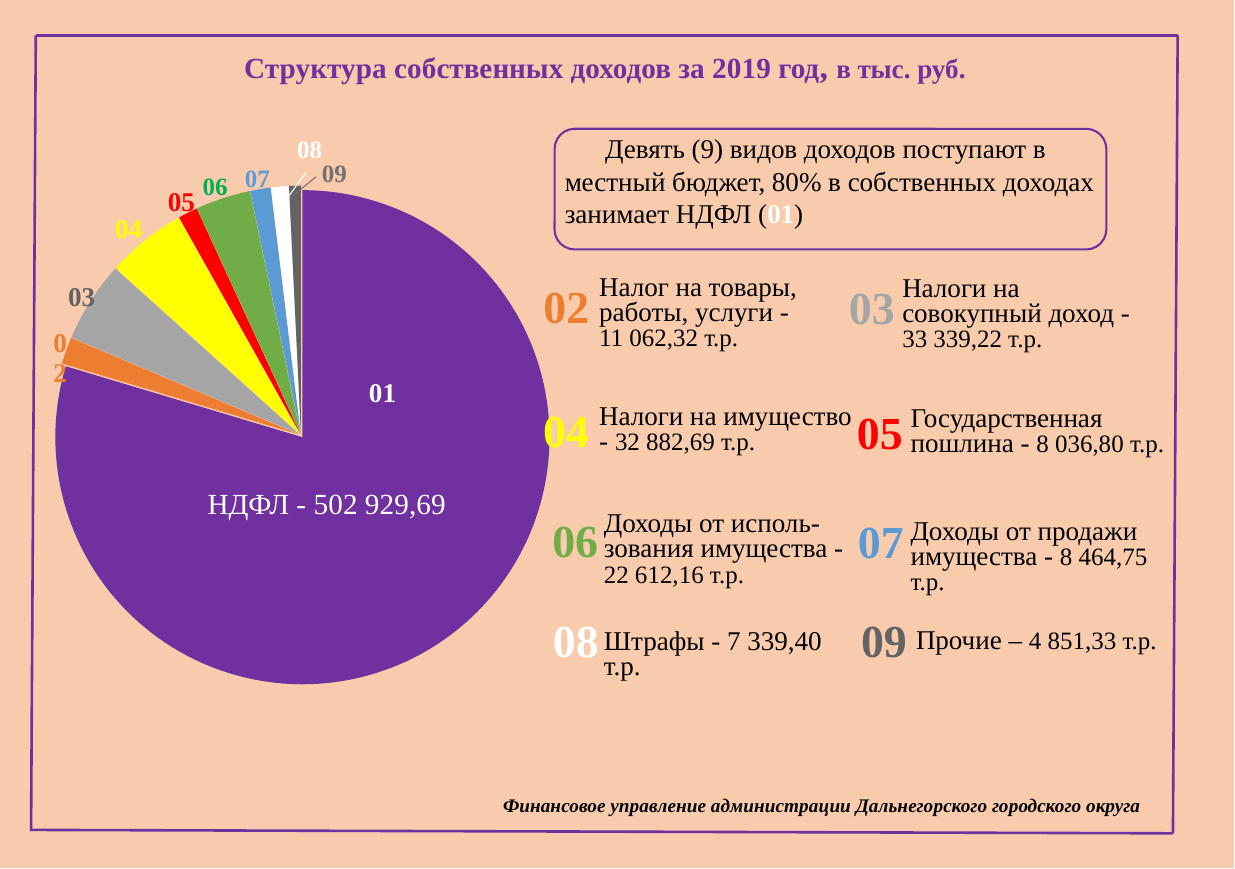
How many slices does the pie chart have? 9 What is the value for НДФЛ (01)? 502 929,69 What is the value for Штрафы (08)? 7 339,40 т.р. What kind of chart is shown on the slide? pie chart Which income type has the largest slice of the pie? НДФЛ (01) Which is larger: Доходы от использования имущества (06) or Налог на товары, работы, услуги (02)? Доходы от использования имущества (06) What share of own income does НДФЛ (01) account for, according to the slide? 80% What is the value for Налоги на совокупный доход (03)? 33 339,22 т.р. What is the title of the chart? Структура собственных доходов за 2019 год, в тыс. руб. Which income type has the smallest slice of the pie? Прочие (09) What is the difference between Доходы от продажи имущества (07) and Государственная пошлина (05)? 427,95 т.р. What is the difference between Доходы от использования имущества (06) and Налог на товары, работы, услуги (02)? 11 549,84 т.р.